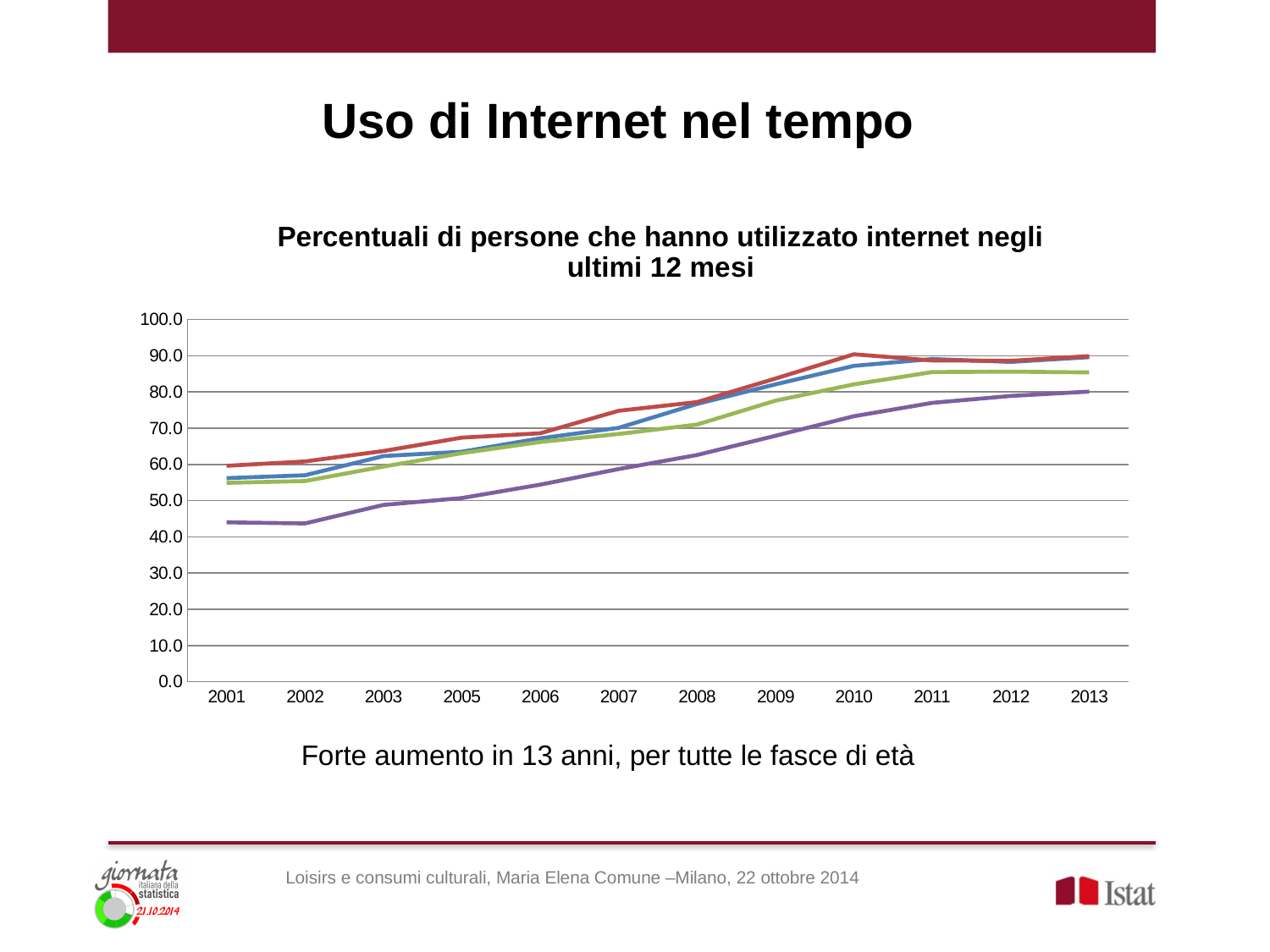
How many years are plotted along the x axis of the chart? 12 Is the value of the purple line in 2001 greater or less than 50.0? less In 2013, which line has the larger value, the green line or the purple line? green line Do the values of the purple line rise or fall from 2001 to 2013? rise How many lines are plotted on the chart? 4 What is the title of the chart? Percentuali di persone che hanno utilizzato internet negli ultimi 12 mesi What kind of chart is shown on the slide? line chart Which line has the lowest values across all years on the chart? purple line Is the value of the blue line in 2008 greater or less than 70.0? greater In 2001, which line has the larger value, the red line or the purple line? red line Is the value of the red line in 2013 greater or less than 80.0? greater